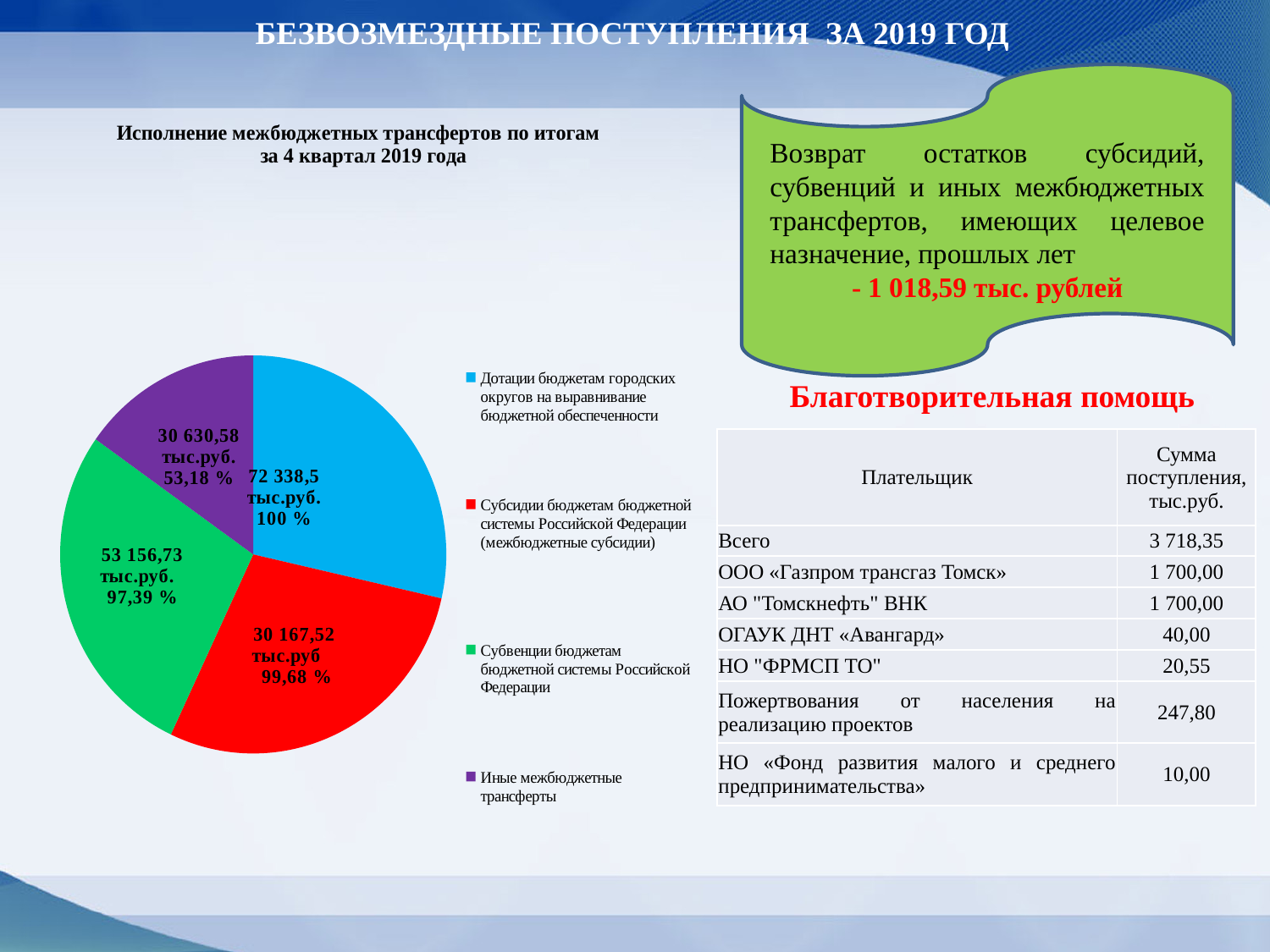
What percentage is printed on the slice 'Субсидии бюджетам бюджетной системы Российской Федерации (межбюджетные субсидии)'? 99,68 % What amount is shown for the slice 'Субвенции бюджетам бюджетной системы Российской Федерации'? 53 156,73 тыс.руб. What amount is shown for the slice 'Иные межбюджетные трансферты'? 30 630,58 тыс.руб. Which is larger: the amount for 'Субвенции бюджетам бюджетной системы Российской Федерации' or for 'Дотации бюджетам городских округов'? Дотации бюджетам городских округов What is the difference in amount between the 'Дотации' slice and the 'Субсидии' slice? 42 170,98 тыс.руб. What percentage is printed on the slice 'Иные межбюджетные трансферты'? 53,18 % What type of chart is shown on the slide? pie chart What amount is shown for the slice 'Дотации бюджетам городских округов на выравнивание бюджетной обеспеченности'? 72 338,5 тыс.руб. How many slices does the pie chart have? 4 Which slice of the pie chart has the smallest amount? Субсидии бюджетам бюджетной системы Российской Федерации (межбюджетные субсидии) What colour is the slice for 'Субвенции бюджетам бюджетной системы Российской Федерации' in the pie chart? green Which slice of the pie chart has the largest amount? Дотации бюджетам городских округов на выравнивание бюджетной обеспеченности